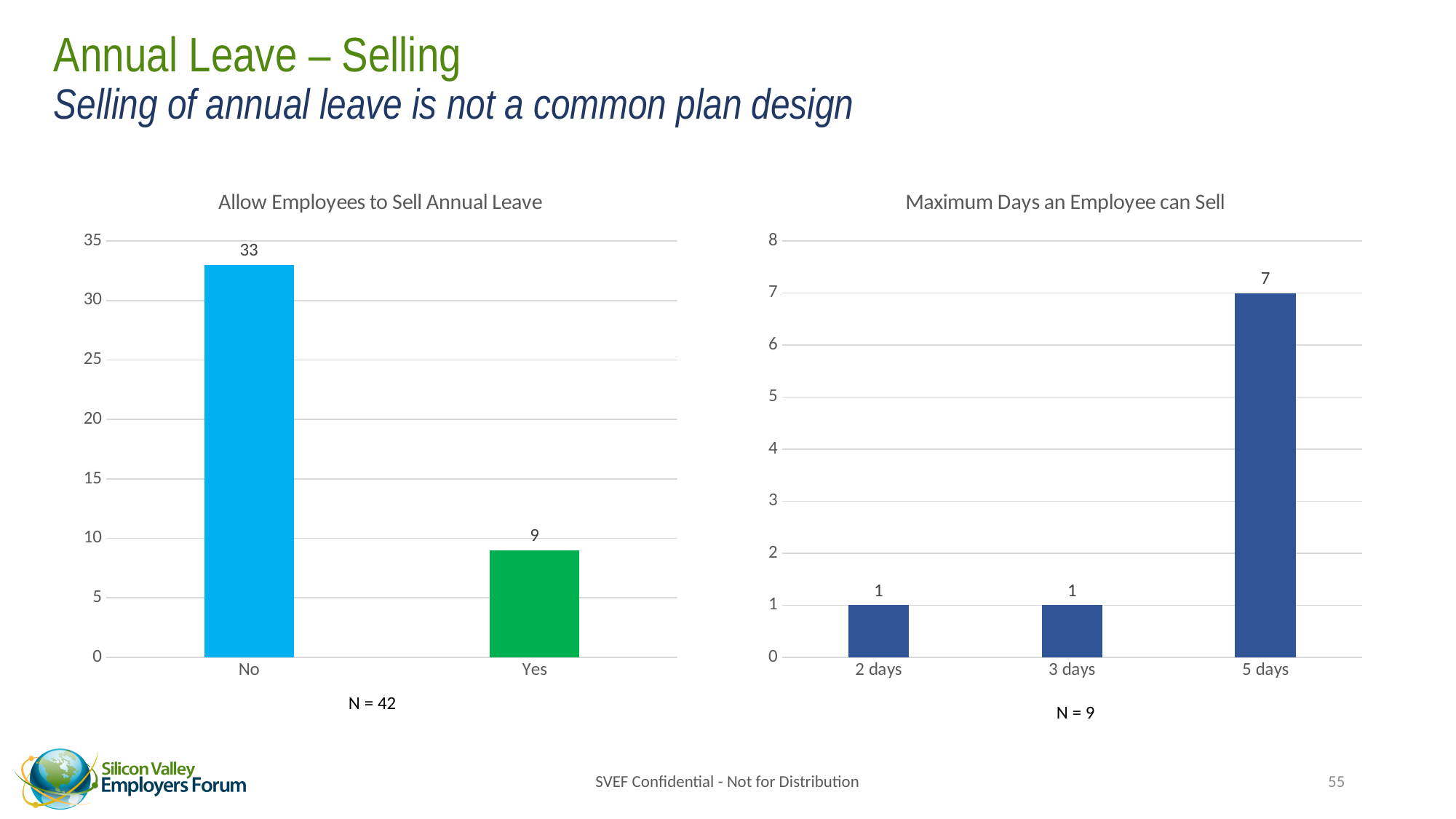
In the 'Allow Employees to Sell Annual Leave' chart, what is the value for Yes? 9 In the 'Maximum Days an Employee can Sell' chart, what is the value for 5 days? 7 In the 'Allow Employees to Sell Annual Leave' chart, what is the value for No? 33 In the 'Maximum Days an Employee can Sell' chart, what is the difference between the values for 5 days and 3 days? 6 In the 'Allow Employees to Sell Annual Leave' chart, which category has the higher value, No or Yes? No In the 'Maximum Days an Employee can Sell' chart, what is the value for 2 days? 1 In the 'Maximum Days an Employee can Sell' chart, how many categories are shown? 3 In the 'Allow Employees to Sell Annual Leave' chart, how many categories are shown? 2 In the 'Maximum Days an Employee can Sell' chart, which category has the highest value? 5 days In the 'Allow Employees to Sell Annual Leave' chart, what is the difference between the No and Yes values? 24 What kind of chart is 'Allow Employees to Sell Annual Leave'? Bar chart What is the N value shown below the 'Maximum Days an Employee can Sell' chart? N = 9